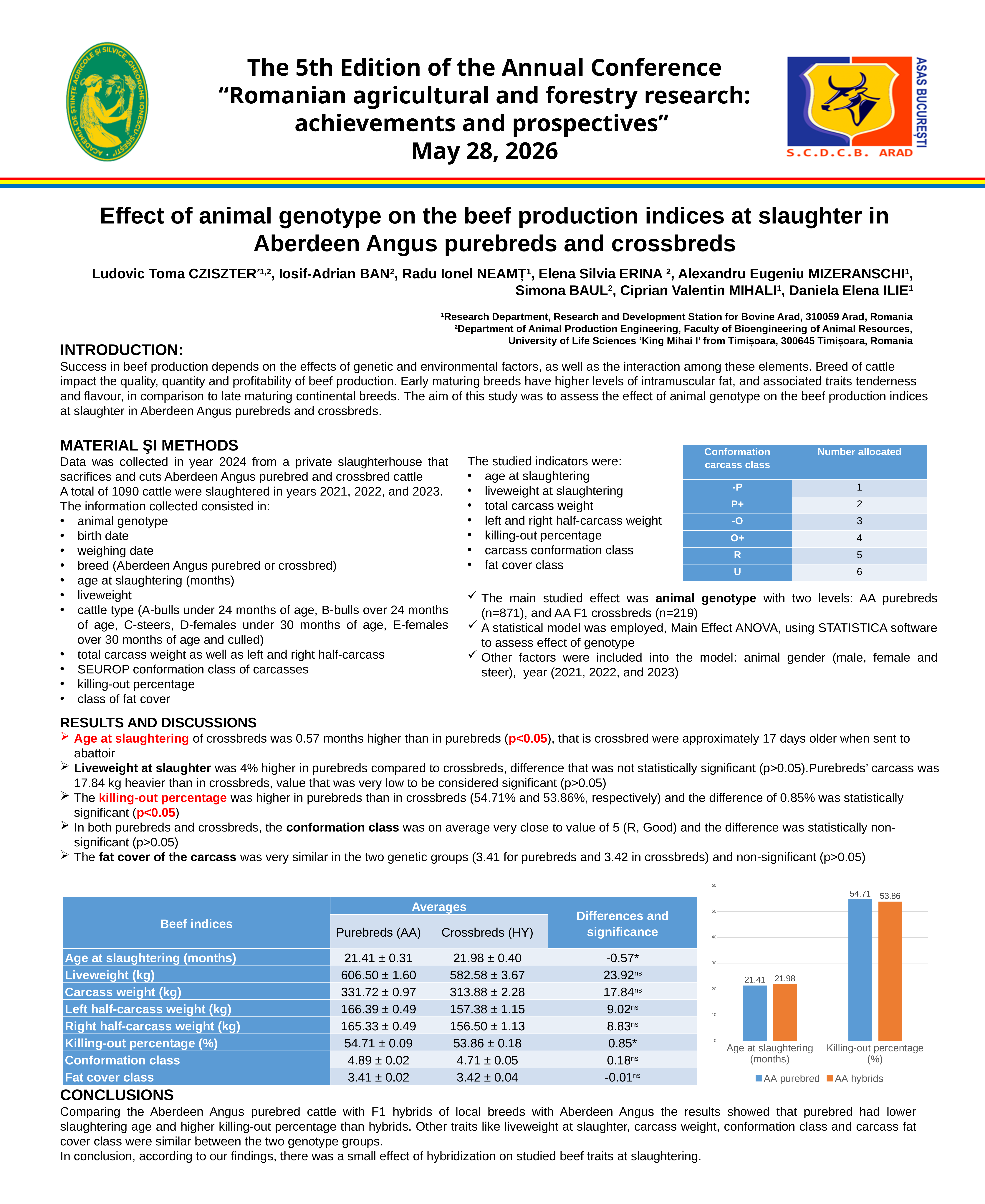
What is the difference between the AA purebred and AA hybrids values for Killing-out percentage (%)? 0.85 Which series is shown in orange in the chart? AA hybrids What is the value for AA purebred for Killing-out percentage (%)? 54.71 Is the AA purebred value for Killing-out percentage (%) greater or less than 50? greater What is the difference between the AA hybrids and AA purebred values for Age at slaughtering (months)? 0.57 What is the value for AA hybrids for Killing-out percentage (%)? 53.86 What is the value for AA hybrids for Age at slaughtering (months)? 21.98 What is the value for AA purebred for Age at slaughtering (months)? 21.41 How many categories are shown on the x axis of the chart? 2 What kind of chart is shown on the slide? bar chart Which category has the highest value for AA purebred? Killing-out percentage (%) How many series does the chart legend list? 2